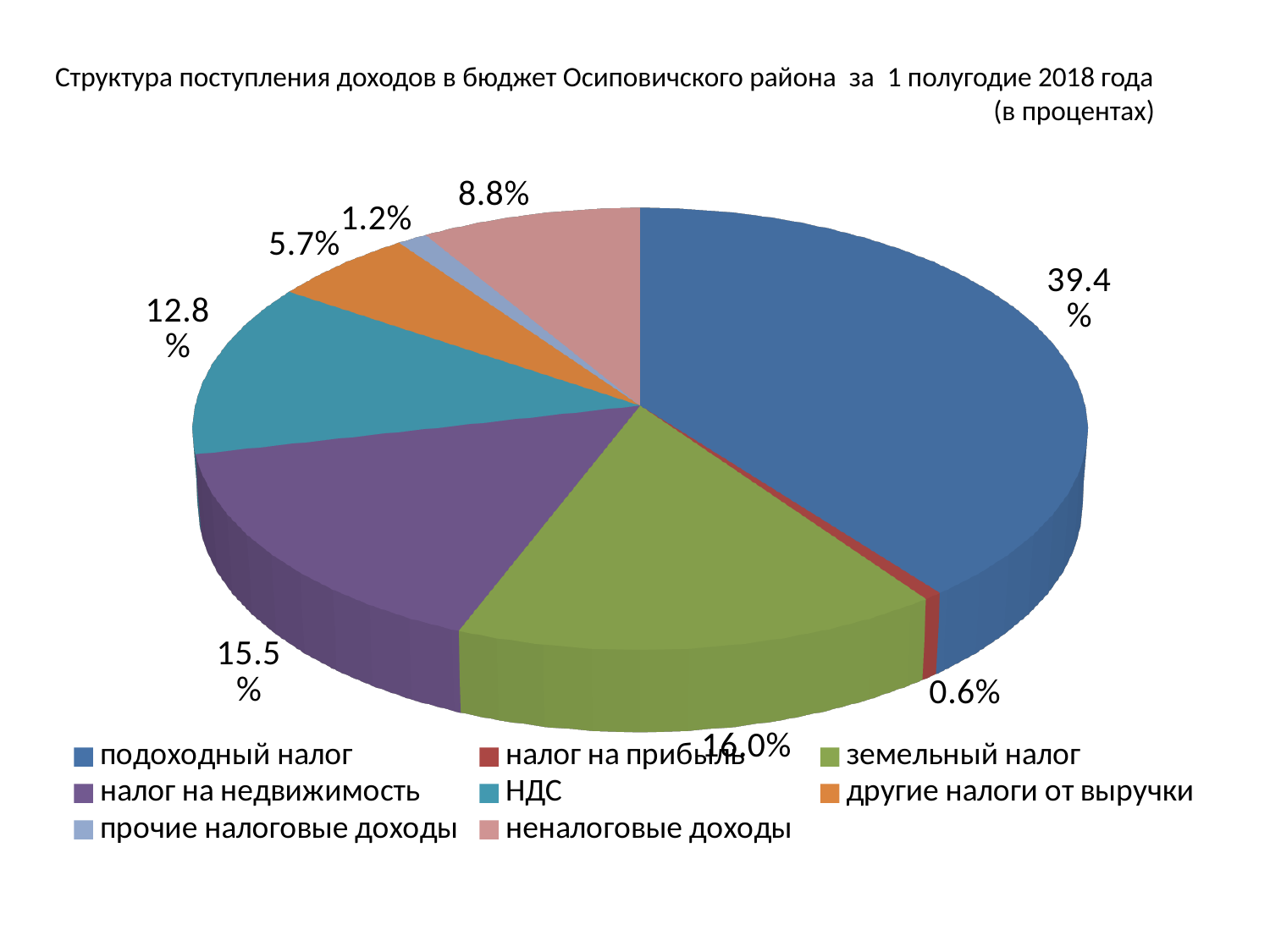
What share of the budget revenue comes from НДС? 12.8% What type of chart is shown on the slide? pie chart What share of the budget revenue comes from подоходный налог? 39.4% How many categories does the pie chart show? 8 What share of the budget revenue comes from неналоговые доходы? 8.8% What colour is the slice for другие налоги от выручки? orange What share of the budget revenue comes from налог на прибыль? 0.6% Which category has the largest share of the budget revenue? подоходный налог What is the difference in percentage points between подоходный налог and земельный налог? 23.4 What share of the budget revenue comes from земельный налог? 16.0% Which category has the smallest share of the budget revenue? налог на прибыль Which is larger: the share of налог на недвижимость or the share of НДС? налог на недвижимость